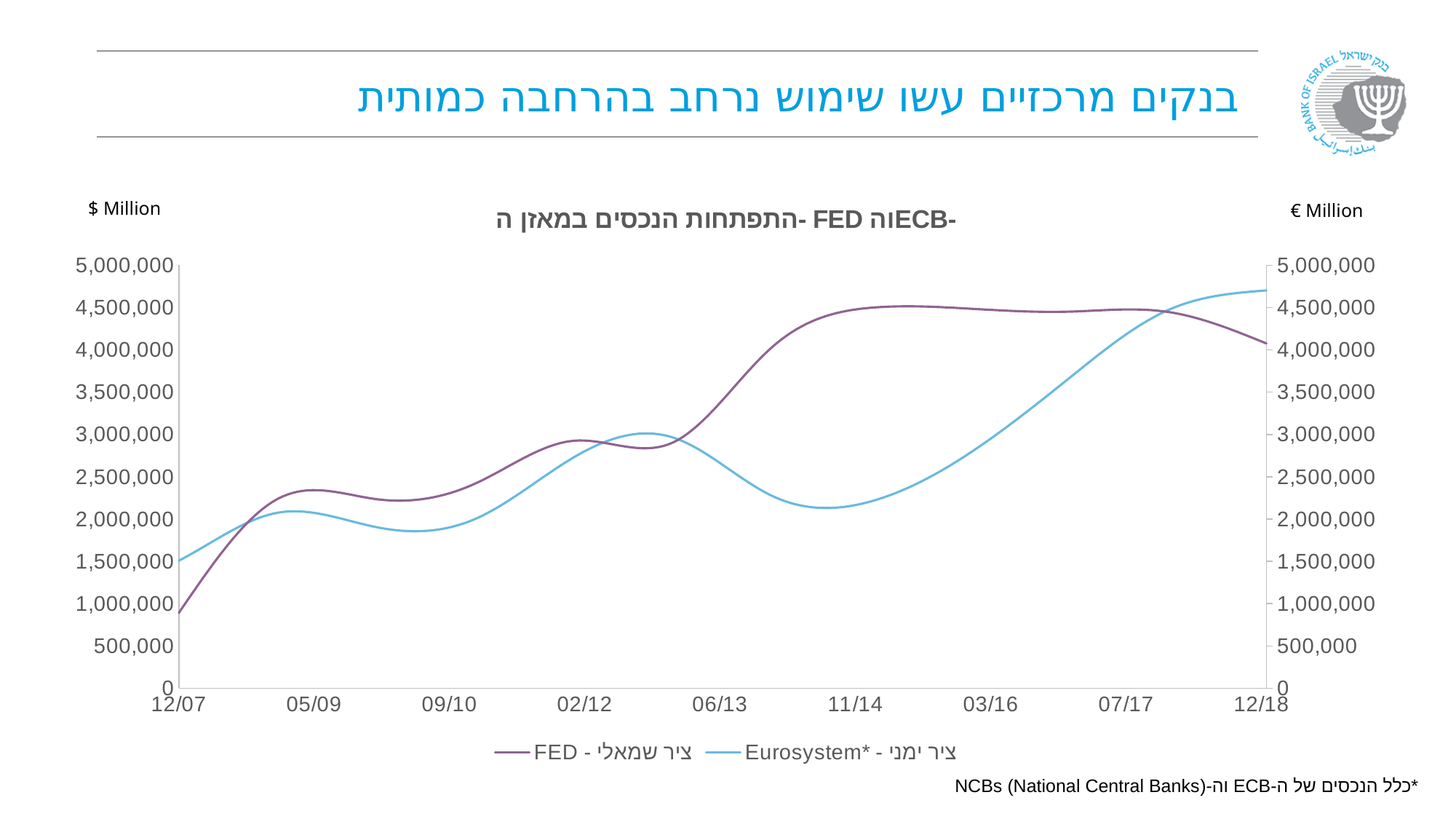
Is the value for Eurosystem* at 12/18 greater or less than 4,500,000? greater Is the value for Eurosystem* at 11/14 greater or less than 2,500,000? less Does the Eurosystem* line rise or fall between 11/14 and 12/18? rise How many series does the legend list? 2 Which series is plotted on the left axis according to the legend? FED What unit label appears above the right-hand axis? € Million Is the value for FED at 05/09 greater or less than 2,000,000? greater What kind of chart is shown on the slide? line chart How many date labels are shown along the x axis? 9 At 11/14, which series has the higher value, FED or Eurosystem*? FED At 12/18, which series has the higher value, FED or Eurosystem*? Eurosystem*